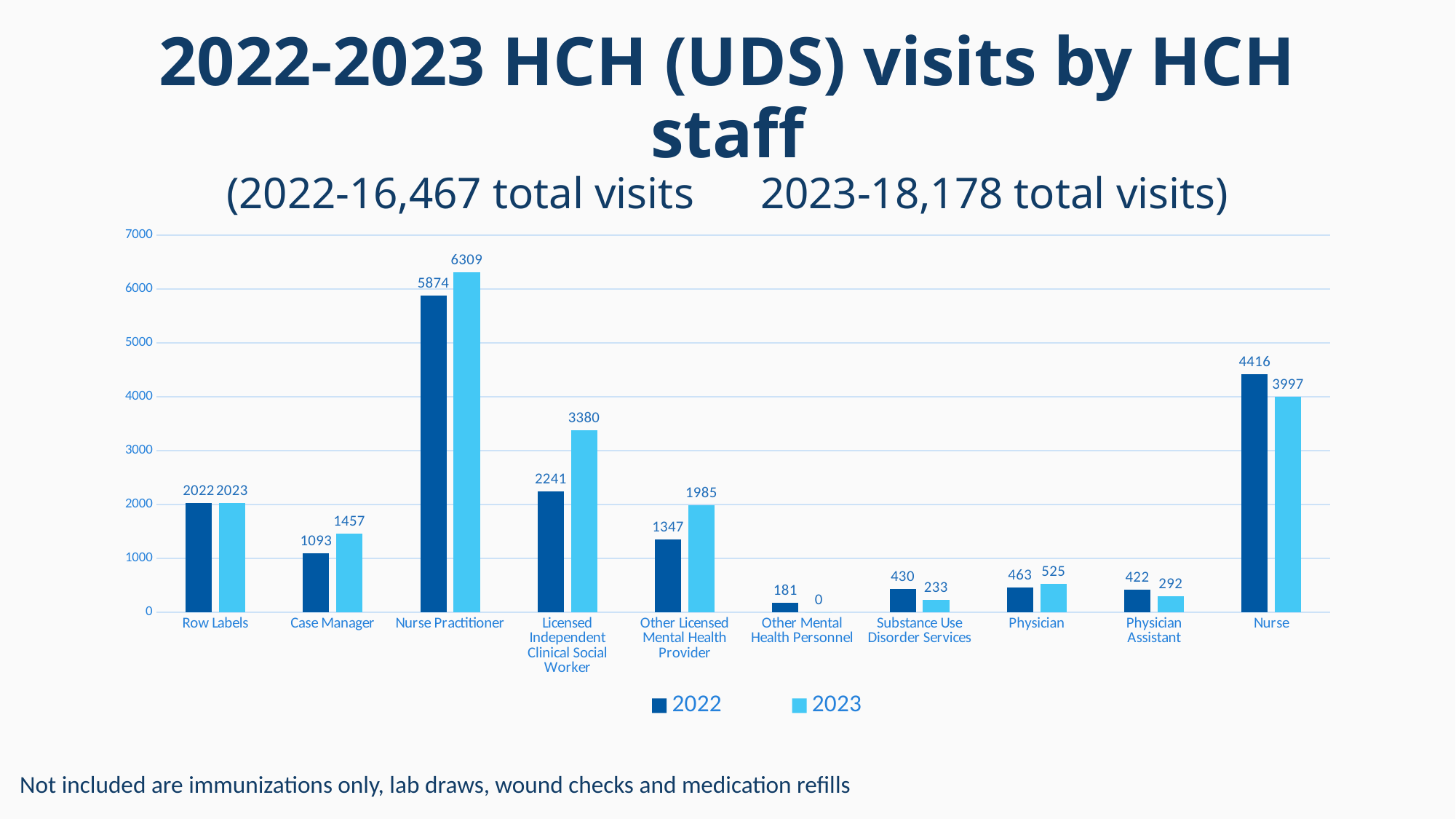
What kind of chart is shown on the slide? bar chart What is the 2022 value for Licensed Independent Clinical Social Worker? 2241 How many series does the legend list? 2 Is the 2023 value for Licensed Independent Clinical Social Worker greater or less than 3000? greater What is the difference between the 2023 and 2022 values for Nurse? 419 What is the 2023 value for Other Mental Health Personnel? 0 Which category has the highest 2022 value? Nurse Practitioner Which category has the lowest 2023 value? Other Mental Health Personnel What is the 2023 value for Nurse Practitioner? 6309 Which colour represents the 2023 series in the legend? light blue Which is larger for Substance Use Disorder Services, the 2022 value or the 2023 value? 2022 What is the difference between the 2023 and 2022 values for Case Manager? 364